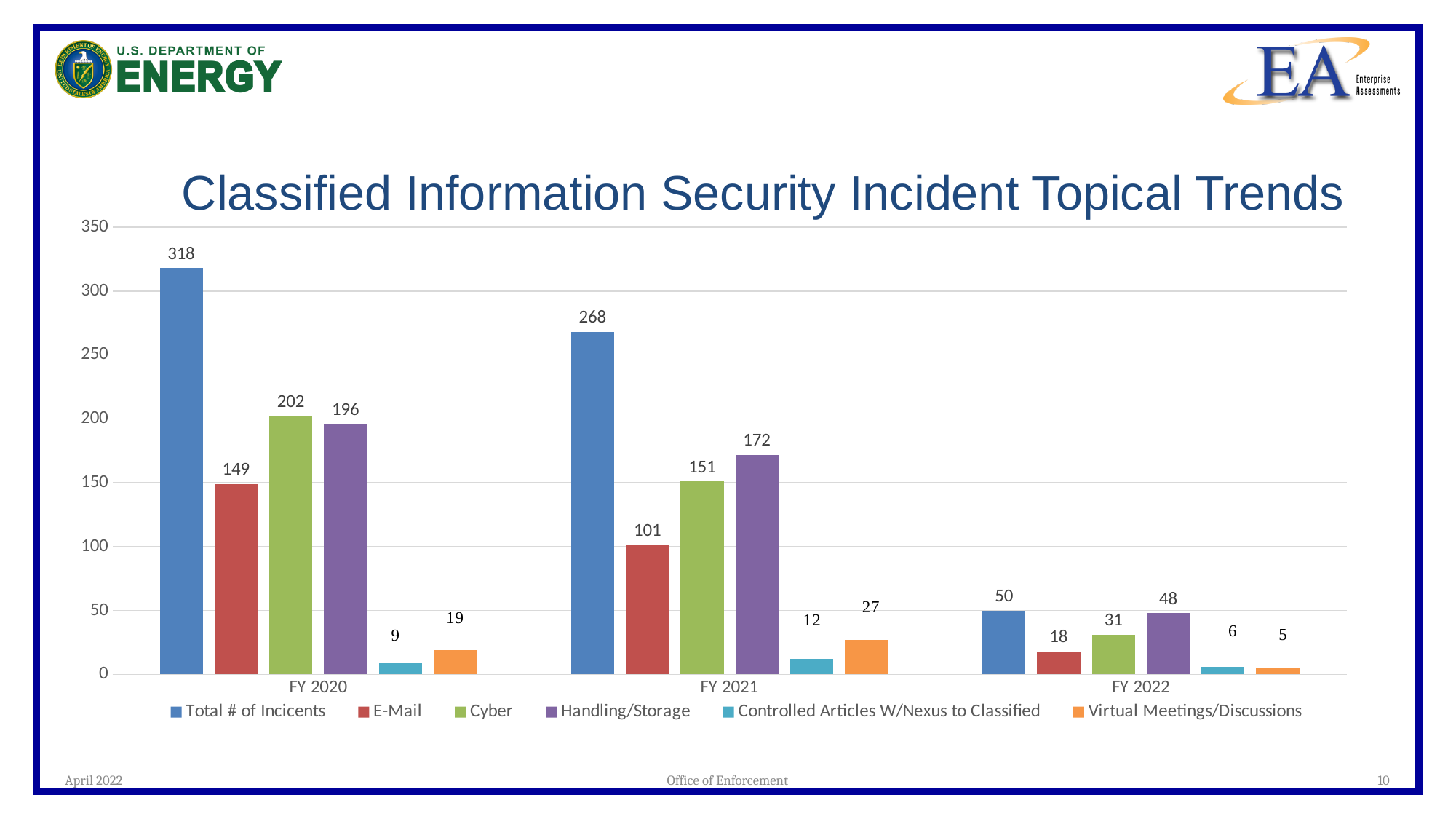
What kind of chart is shown on the slide? Bar chart Which is larger in FY 2020: Cyber or Handling/Storage? Cyber What is the difference between the Total # of Incicents in FY 2020 and FY 2021? 50 How many series does the legend list? 6 In which fiscal year is the Total # of Incicents highest? FY 2020 Does the Total # of Incicents rise or fall from FY 2020 to FY 2022? Fall In which fiscal year is the E-Mail value lowest? FY 2022 What is the Handling/Storage value for FY 2022? 48 How many fiscal years are shown on the x axis? 3 What is the Virtual Meetings/Discussions value for FY 2021? 27 What is the Total # of Incicents value for FY 2020? 318 What is the Cyber value for FY 2021? 151